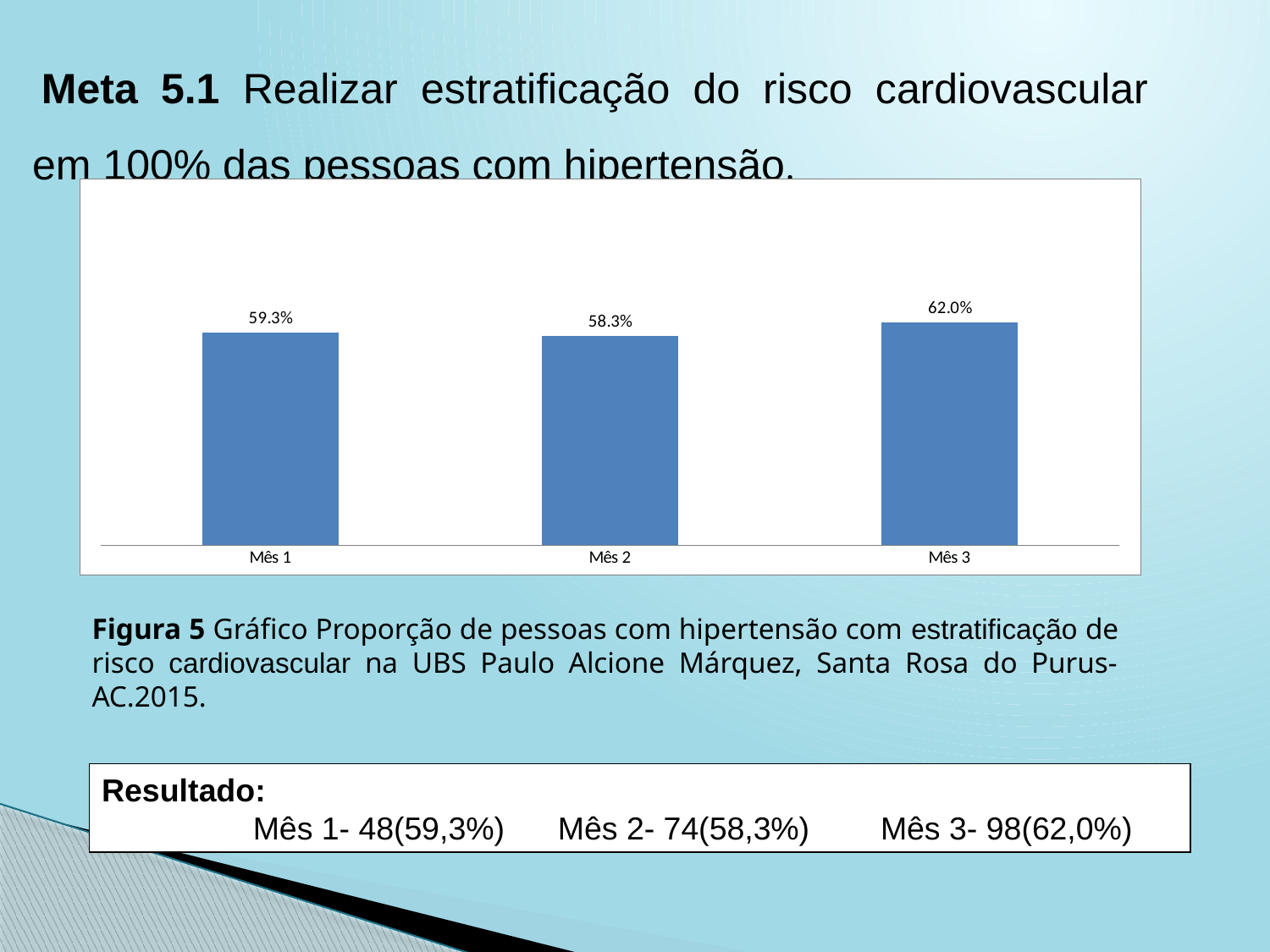
Which month has the lowest value? Mês 2 Which is larger, the value for Mês 3 or the value for Mês 2? Mês 3 What is the value for Mês 2? 58.3% What kind of chart is shown on the slide? Bar chart What is the value for Mês 1? 59.3% Does the value rise or fall from Mês 2 to Mês 3? Rise Which month has the highest value? Mês 3 What is the difference between the values for Mês 3 and Mês 1? 2.7% What colour are the bars in the chart? Blue What is the value for Mês 3? 62.0% What is the difference between the values for Mês 1 and Mês 2? 1.0% How many categories are shown on the chart? 3